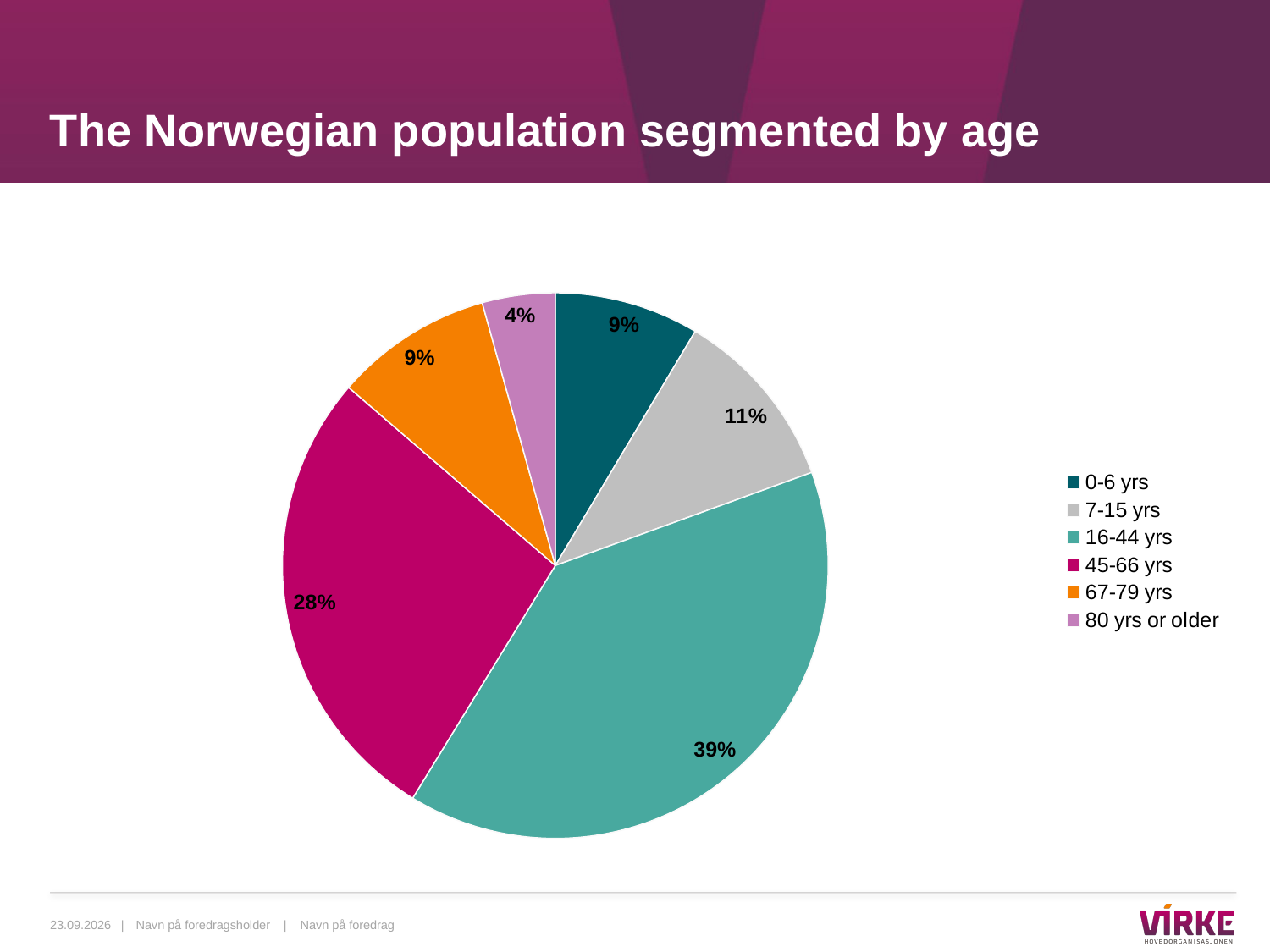
What share of the Norwegian population is 80 yrs or older? 4% What share of the Norwegian population is aged 45-66 yrs? 28% What is the difference in percentage points between the 16-44 yrs and 45-66 yrs shares? 11 What is the title of the chart? The Norwegian population segmented by age How many age groups does the legend list? 6 What kind of chart is shown on the slide? pie chart What share of the Norwegian population is aged 0-6 yrs? 9% Which age group has the largest share of the population? 16-44 yrs What share of the Norwegian population is aged 16-44 yrs? 39% Which age group has the smallest share of the population? 80 yrs or older What share of the Norwegian population is aged 7-15 yrs? 11% Which is larger, the share for 7-15 yrs or the share for 67-79 yrs? 7-15 yrs